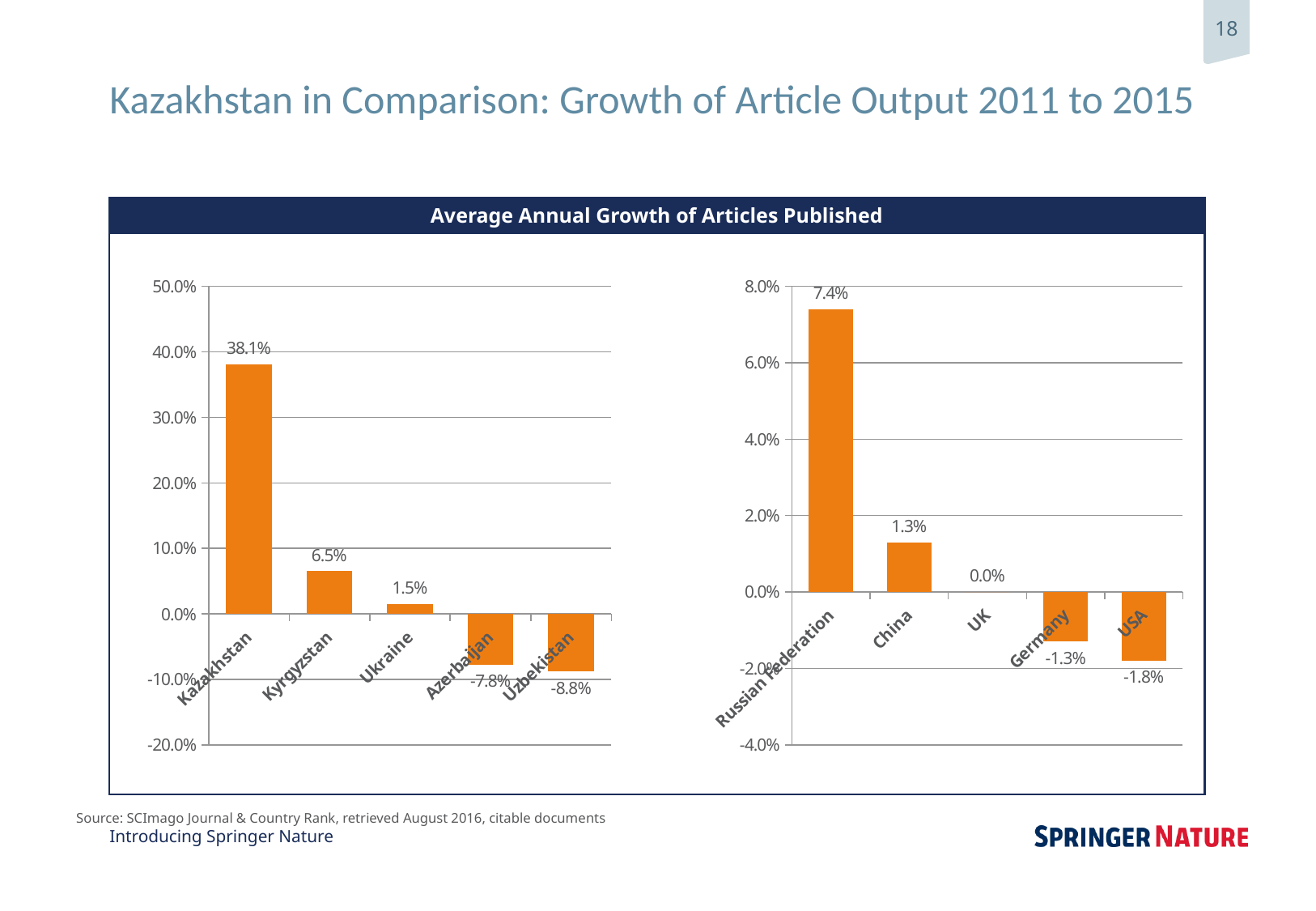
In the right chart, what is the value for the Russian Federation? 7.4% In the right chart, what is the value for Germany? -1.3% In the right chart, which country has the highest average annual growth? Russian Federation In the left chart, which is larger, the value for Ukraine or the value for Kyrgyzstan? Kyrgyzstan In the right chart, which country has the lowest value? USA In the left chart, what is the value for Kyrgyzstan? 6.5% In the left chart, what is the average annual growth of articles published for Kazakhstan? 38.1% In the left chart, what is the difference between the values for Kazakhstan and Kyrgyzstan? 31.6% In the right chart, what is the difference between the values for the Russian Federation and China? 6.1% How many countries are shown in the right chart? 5 In the left chart, which country has the lowest average annual growth? Uzbekistan What type of chart is the left chart? Bar chart